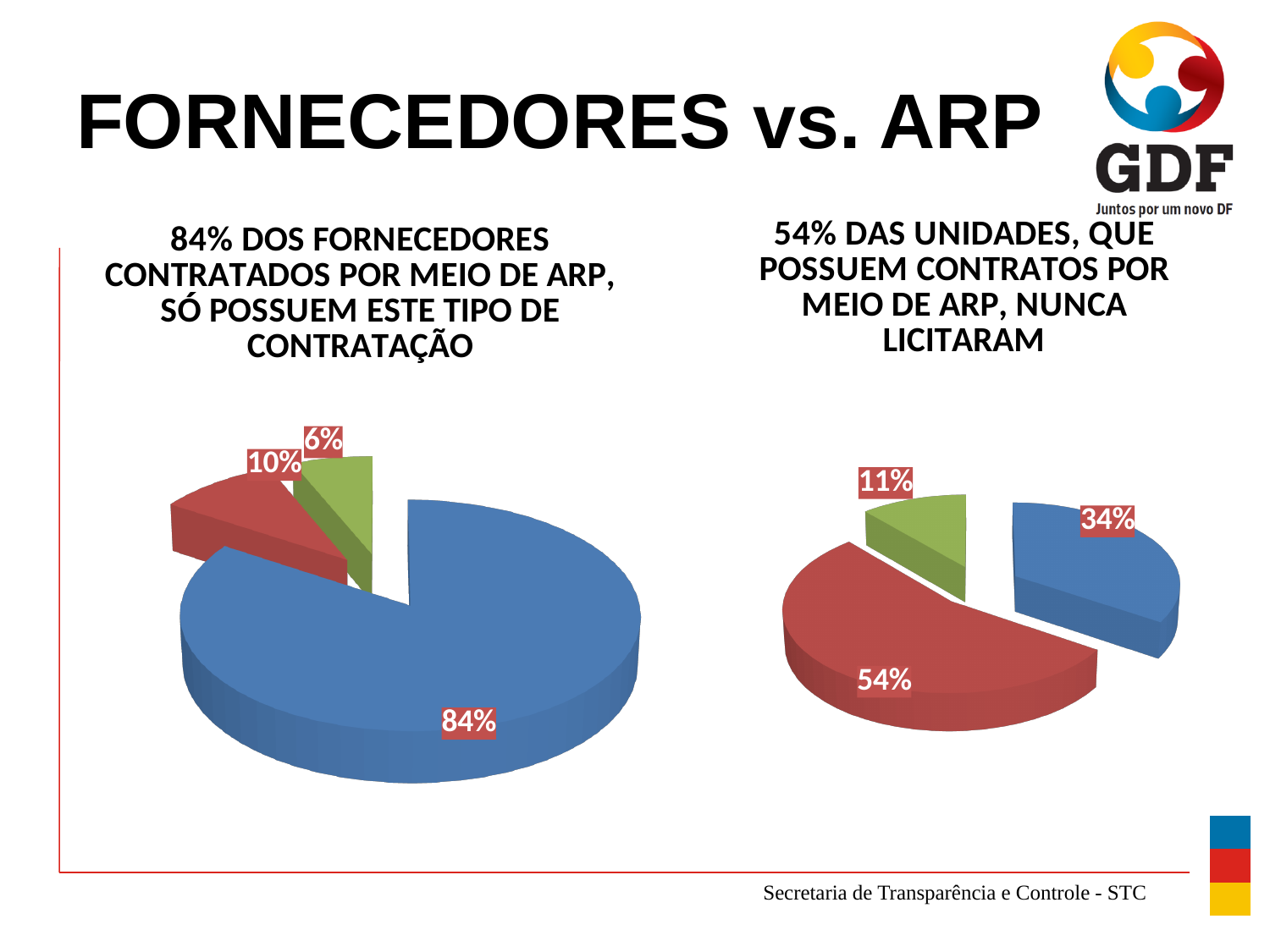
What kind of chart is shown on the left side of the slide? Pie chart What kind of chart is shown on the right side of the slide? Pie chart In the right pie chart, what is the difference between the red slice and the blue slice? 20% In the right pie chart, what percentage is shown on the blue slice? 34% In the right pie chart, what percentage is shown on the green slice? 11% How many slices does the left pie chart have? 3 In the left pie chart, which colour slice is the smallest? Green In the left pie chart, what percentage is shown on the green slice? 6% In the left pie chart, what percentage is shown on the blue slice? 84% In the right pie chart, what percentage is shown on the red slice? 54% How many slices does the right pie chart have? 3 In the left pie chart, what percentage is shown on the red slice? 10%